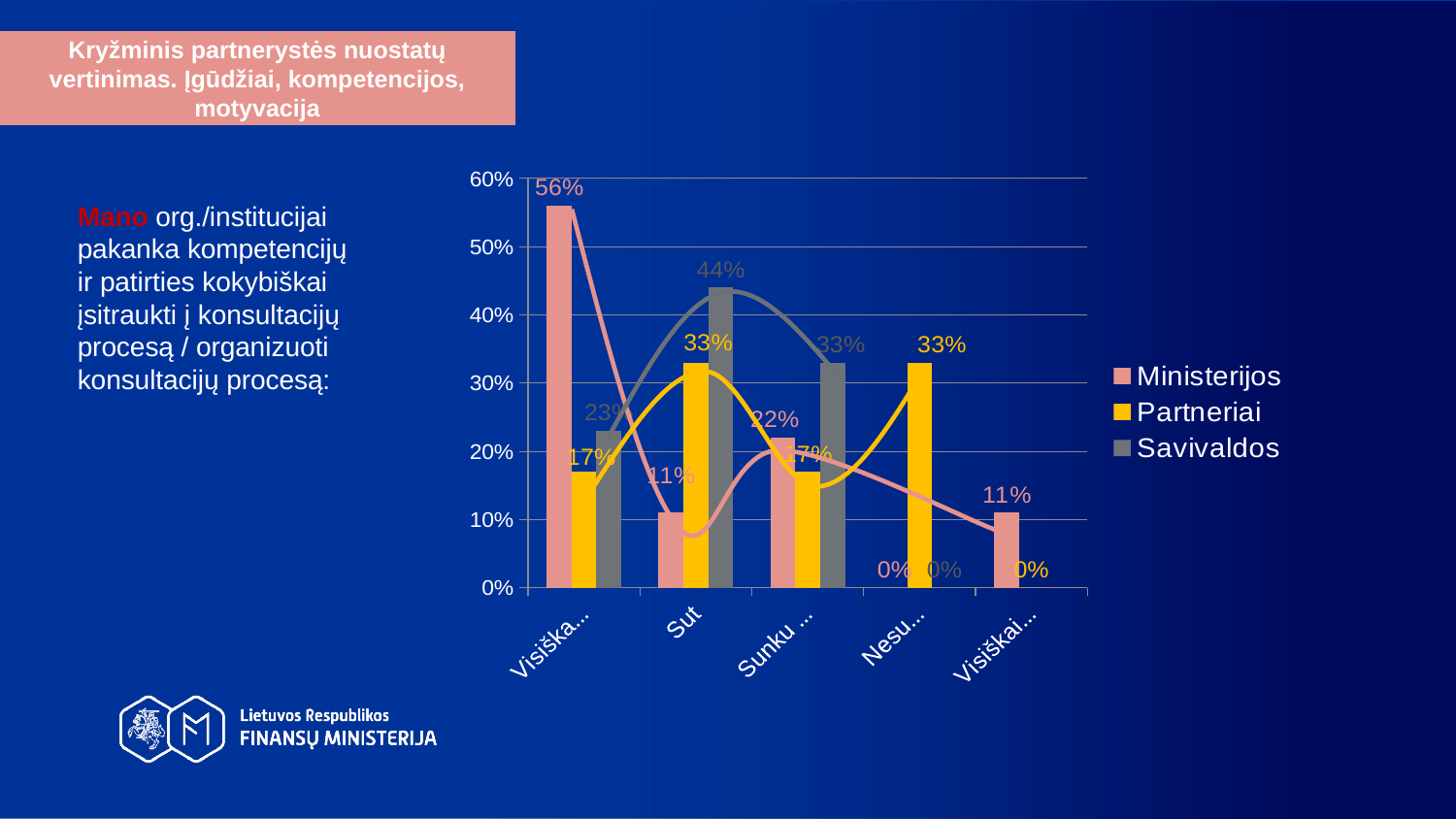
Is the Ministerijos value in the "Sut" category greater or less than 20%? less What is the value for Savivaldos in the "Sut" category? 44% What is the value for Ministerijos in the "Sut" category? 11% How many series does the chart legend list? 3 What is the highest value shown anywhere on the chart? 56% In the "Sut" category, what is the difference between the Savivaldos value and the Ministerijos value? 33 percentage points Which series has the highest value in the "Sut" category? Savivaldos What colour represents the Partneriai series in the legend? yellow How many categories are shown on the x axis? 5 What kind of chart is shown on the slide? bar chart What is the value for Partneriai in the "Sut" category? 33% Which is larger: the Ministerijos value in the first category (56%) or the Savivaldos value in the "Sut" category? Ministerijos in the first category